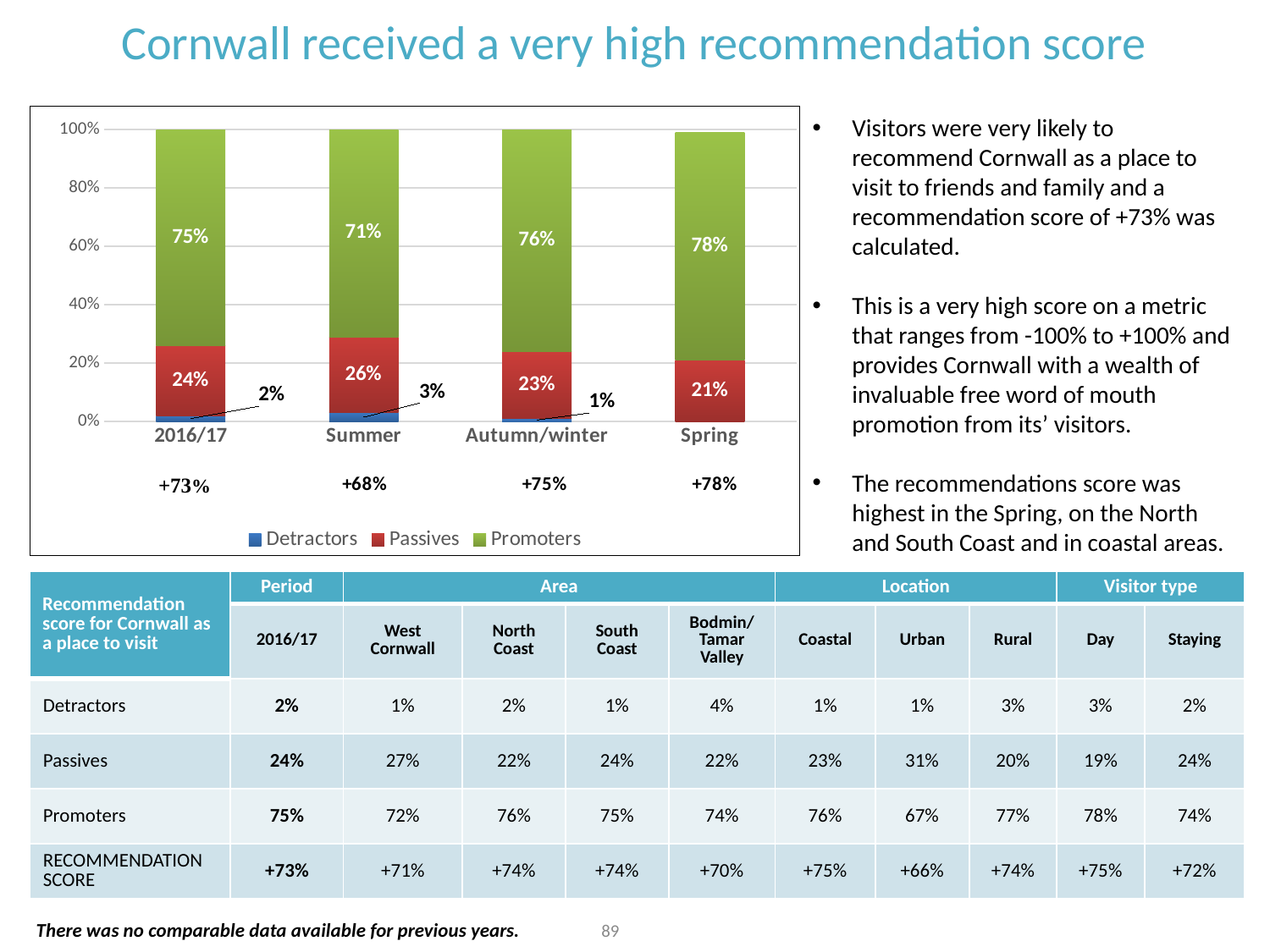
In which period was the Promoters share lowest? Summer In which period was the Promoters share highest? Spring Which series is shown in green in the chart? Promoters What is the recommendation score shown beneath the Summer bar? +68% Which period has the larger Passives share, Summer or Autumn/winter? Summer What percentage of visitors were Promoters in Summer? 71% What is the difference between the Promoters share in Spring and in Summer? 7% How many series does the chart legend list? 3 What percentage of visitors were Passives in Spring? 21% How many periods are shown on the x axis of the chart? 4 What percentage of visitors were Detractors in Autumn/winter? 1% What type of chart is shown on the slide? Stacked bar chart